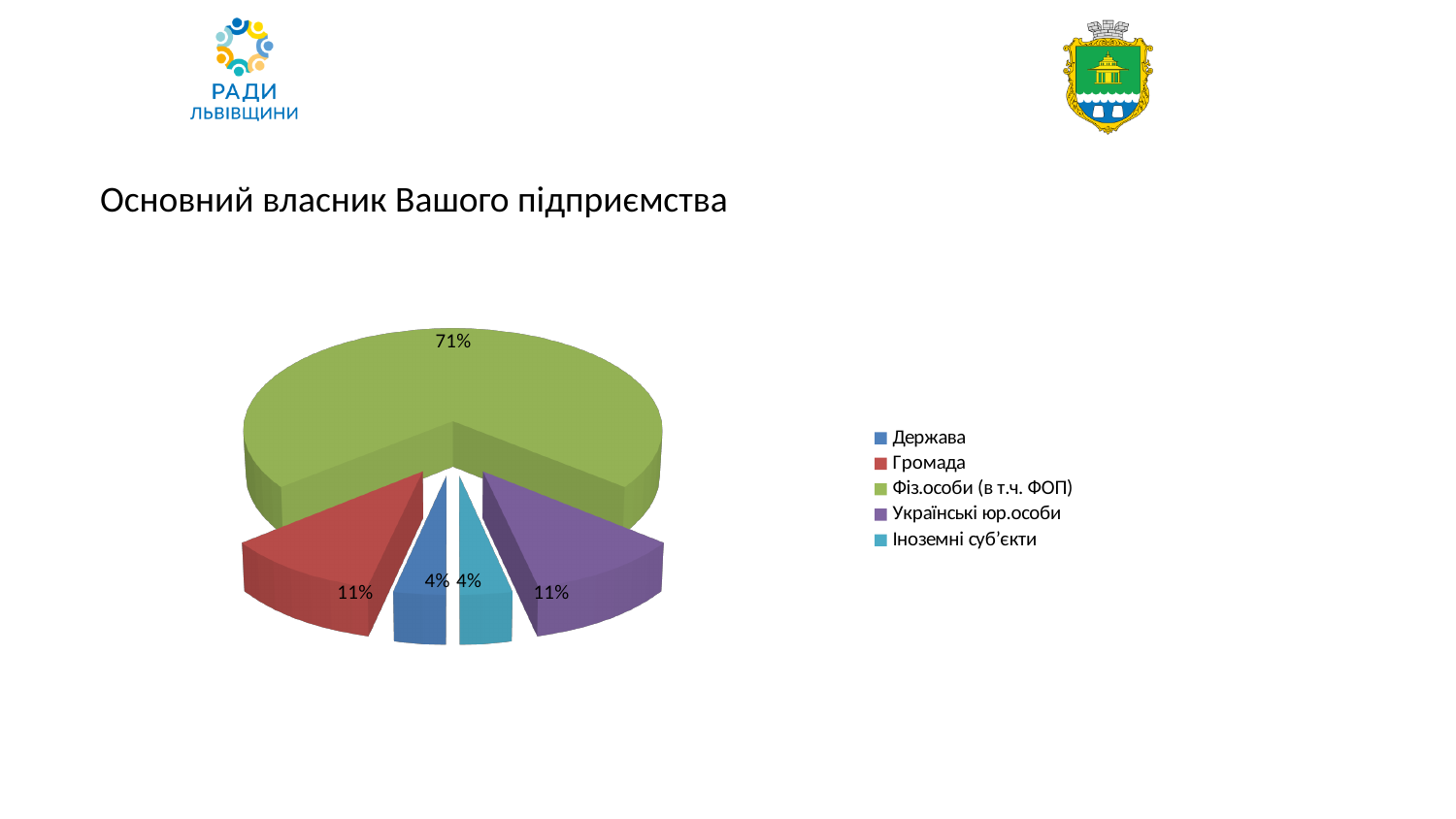
What is the value shown for Іноземні суб'єкти? 4% What is the value shown for Держава? 4% What is the title of the chart? Основний власник Вашого підприємства How many categories are shown in the pie chart? 5 What share of the pie does Фіз.особи (в т.ч. ФОП) hold? 71% What is the value shown for Громада? 11% What is the value shown for Українські юр.особи? 11% Which is larger, the share for Громада or the share for Держава? Громада What is the difference between the share for Фіз.особи (в т.ч. ФОП) and the share for Громада? 60% What kind of chart is shown on the slide? Pie chart Which category has the largest slice of the pie? Фіз.особи (в т.ч. ФОП) How many entries does the legend list? 5